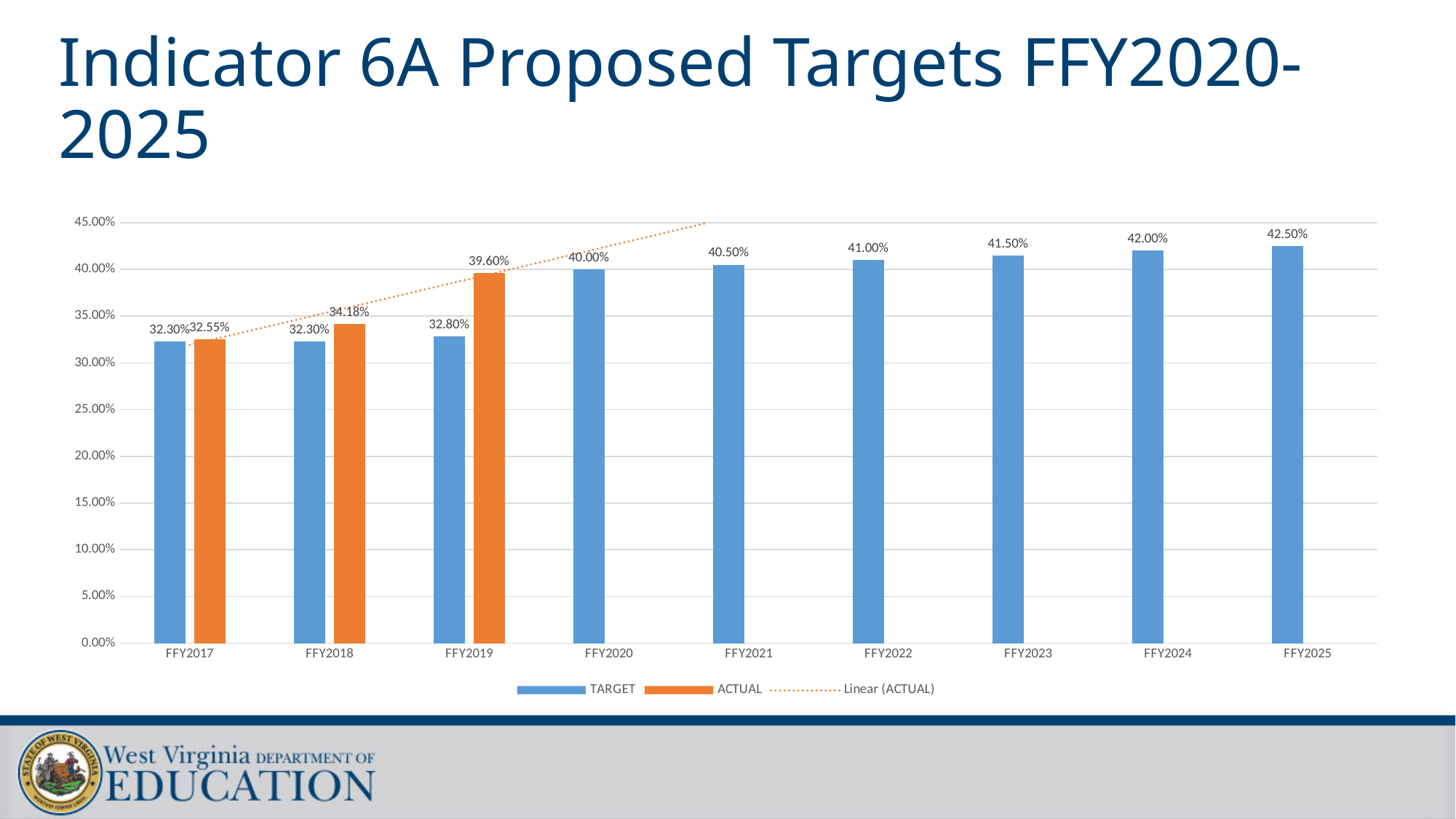
How many years are shown on the x axis? 9 What is the TARGET value for FFY2020? 40.00% Which year has the highest TARGET value? FFY2025 What kind of chart is shown on the slide? Bar chart What is the TARGET value for FFY2025? 42.50% Which is larger for FFY2018, the TARGET or the ACTUAL value? ACTUAL Which year has the highest ACTUAL value? FFY2019 Do the TARGET values rise or fall from FFY2020 to FFY2025? Rise Is the TARGET value for FFY2022 greater or less than 40.00%? greater What is the ACTUAL value for FFY2018? 34.18% How many entries does the legend list? 3 What is the difference between the ACTUAL and TARGET values for FFY2019? 6.80%